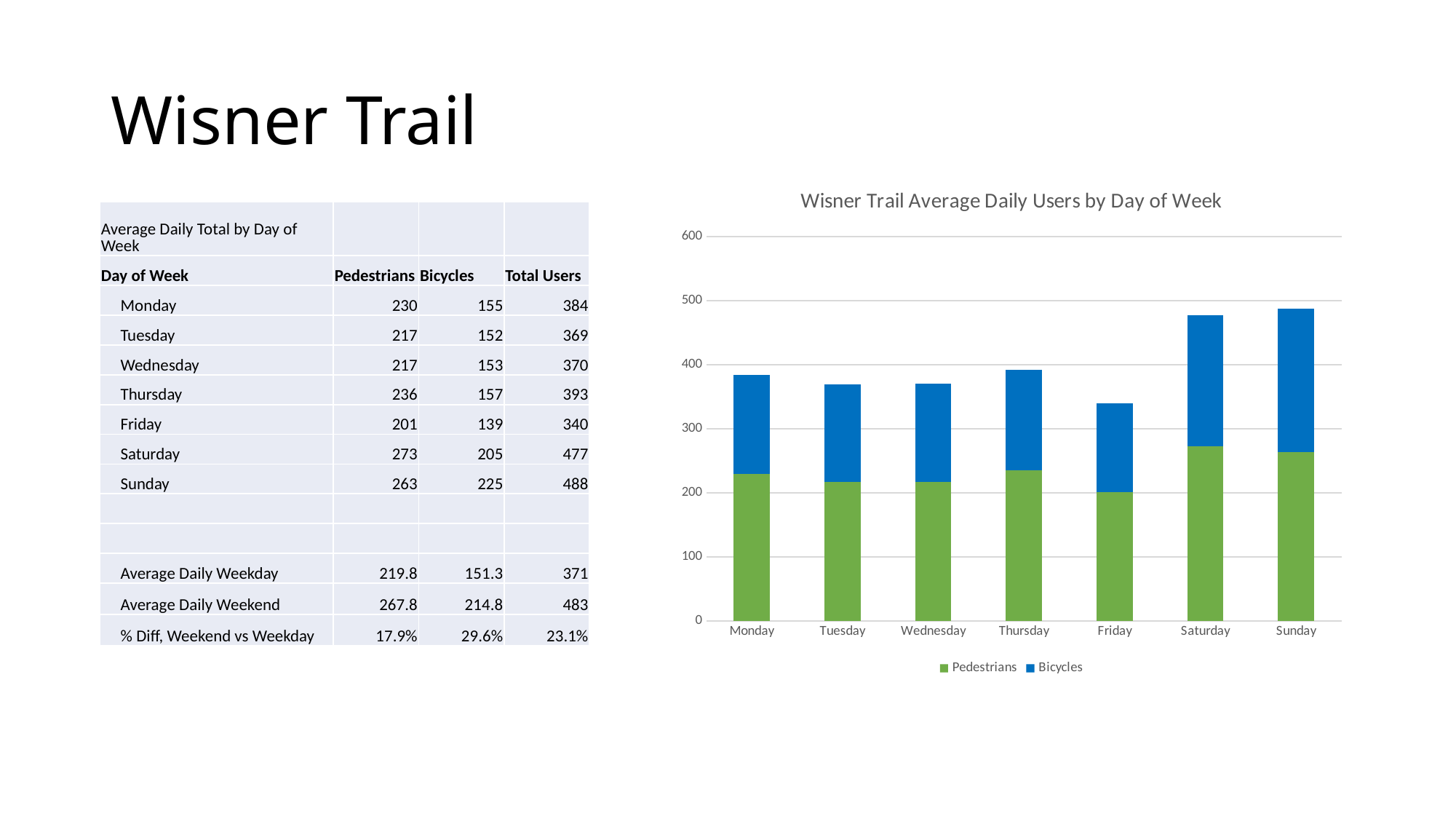
According to the table, what is the Bicycles value for Sunday? 225 Which is larger, the total bar for Thursday or the total bar for Tuesday? Thursday Is the total bar for Friday greater or less than 400? less Is the total bar for Saturday greater or less than 400? greater Is the Pedestrians segment for Sunday greater or less than 200? greater According to the table, what is the Pedestrians value for Saturday? 273 What kind of chart is shown on the slide? stacked bar chart What is the title of the chart? Wisner Trail Average Daily Users by Day of Week How many days of the week are plotted on the x axis of the chart? 7 Which day has the highest total bar in the chart? Sunday Which day has the lowest total bar in the chart? Friday How many series does the chart legend list? 2